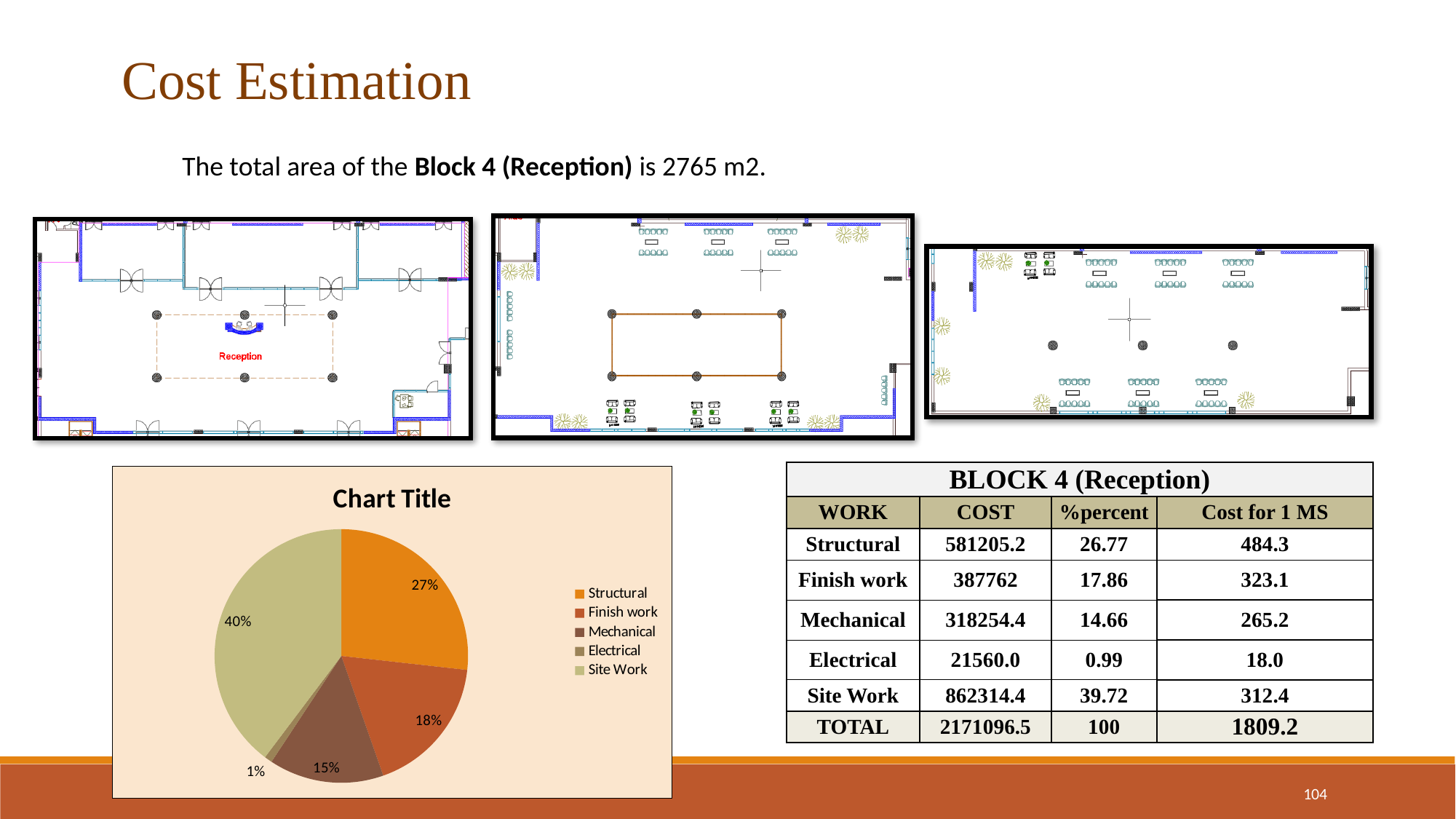
What type of chart is shown on the slide? pie chart Which category has the smallest slice of the pie? Electrical What is the difference in percentage points between the Site Work slice and the Finish work slice? 22 Which category has the largest slice of the pie? Site Work What percentage does the Electrical slice show? 1% How many entries does the chart legend list? 5 What percentage does the Structural slice show? 27% What percentage does the Site Work slice show? 40% How many slices does the pie chart have? 5 Which slice is larger, Structural or Mechanical? Structural What percentage does the Mechanical slice show? 15% What is the title of the chart? Chart Title